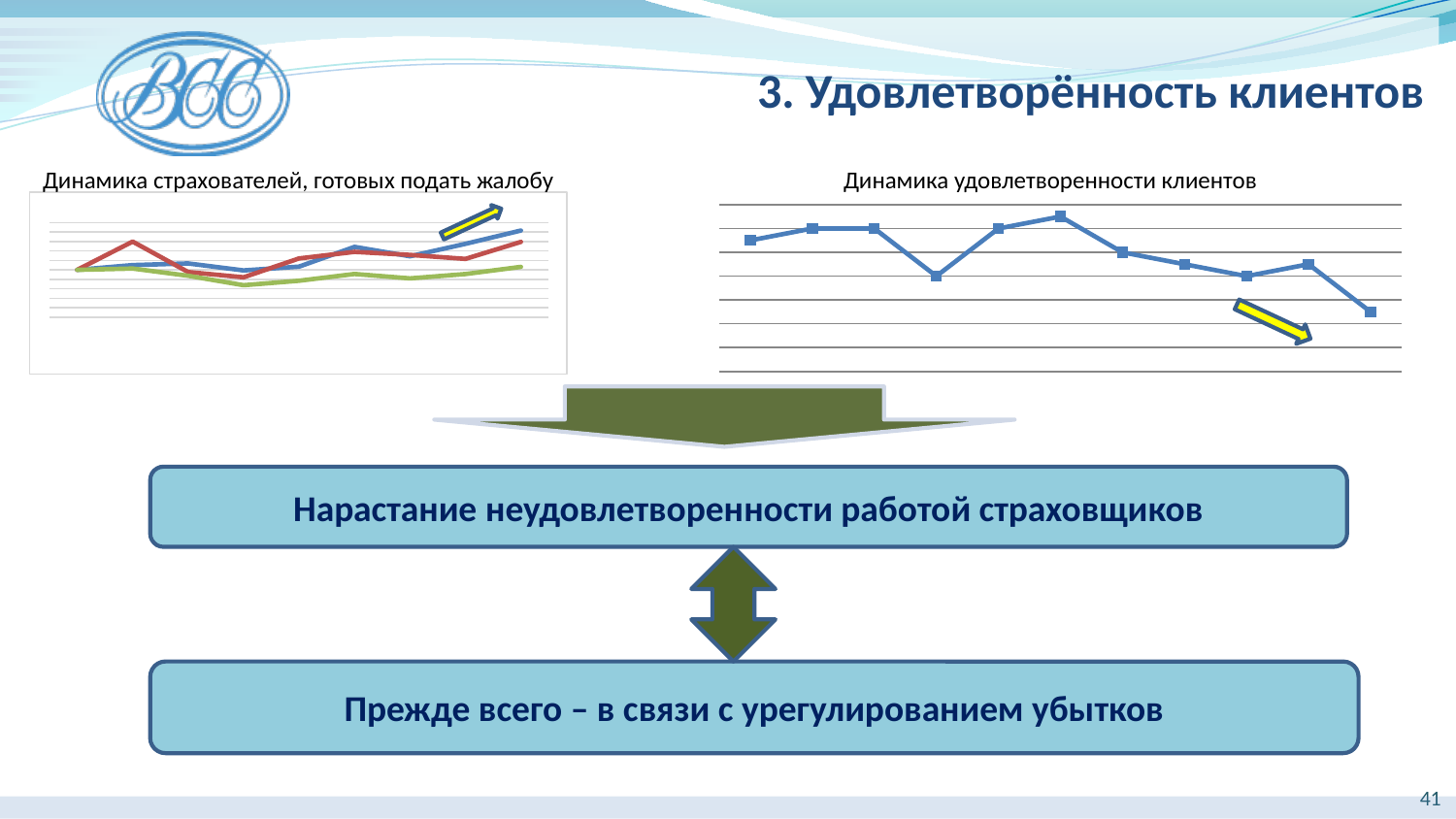
On the chart titled "Динамика удовлетворенности клиентов", is the last point higher or lower than the first point? lower How many data points are plotted on the chart titled "Динамика удовлетворенности клиентов"? 11 On the chart titled "Динамика страхователей, готовых подать жалобу", does the blue line overall rise or fall from left to right? rise How many lines are plotted on the chart titled "Динамика удовлетворенности клиентов"? 1 What kind of chart is the chart titled "Динамика страхователей, готовых подать жалобу"? line chart On the chart titled "Динамика удовлетворенности клиентов", which point is the lowest: the first or the last? the last What kind of chart is the chart titled "Динамика удовлетворенности клиентов"? line chart What is the title of the chart on the left side of the slide? Динамика страхователей, готовых подать жалобу What colours are the three lines on the chart titled "Динамика страхователей, готовых подать жалобу"? blue, red and green How many lines are plotted on the chart titled "Динамика страхователей, готовых подать жалобу"? 3 On the chart titled "Динамика удовлетворенности клиентов", do the values overall rise or fall from left to right? fall